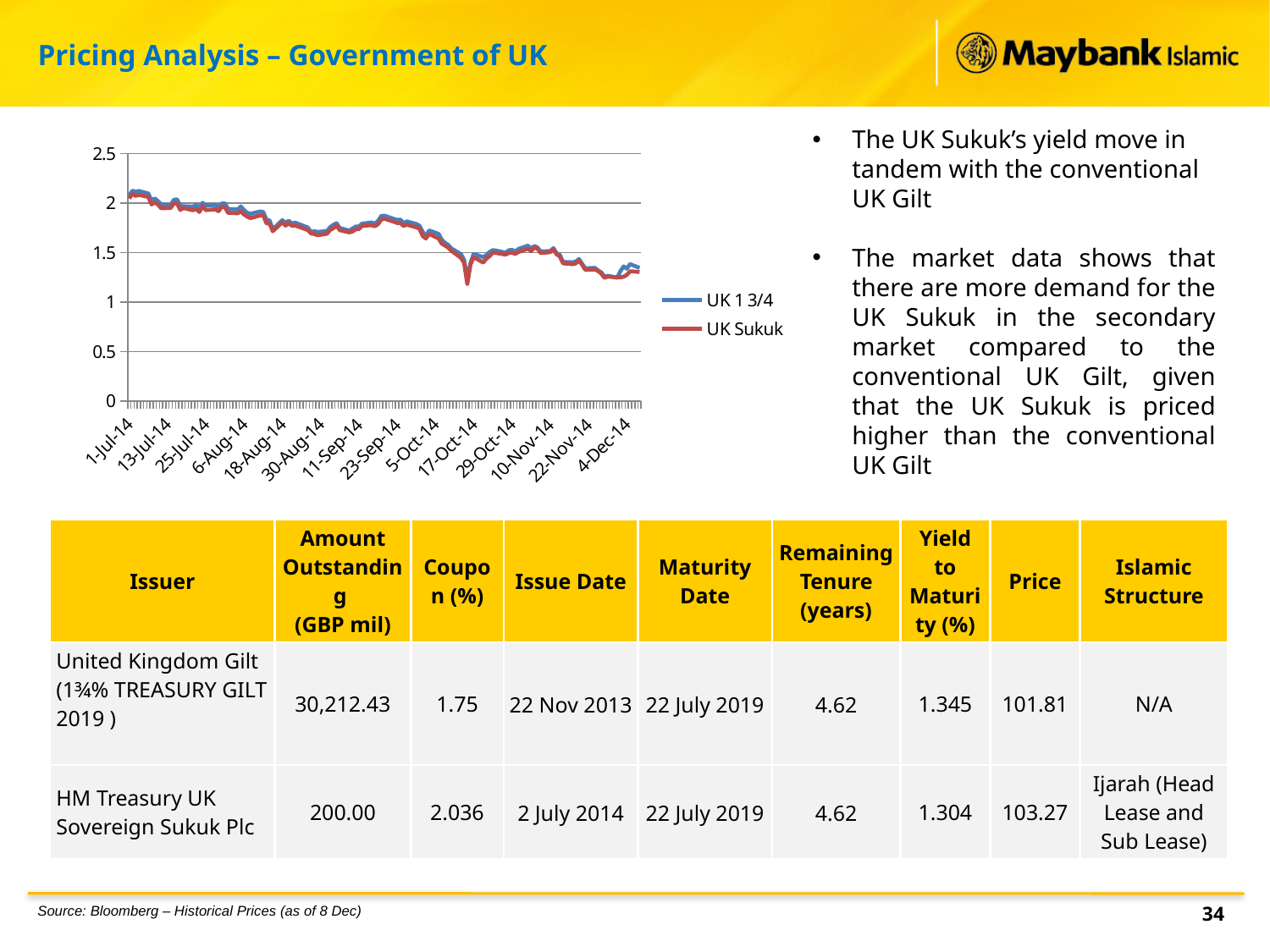
Is the value for UK 1 3/4 at 4-Dec-14 greater or less than 1.5? less Do the yields in the chart generally rise or fall from 1-Jul-14 to 4-Dec-14? fall Is the value for UK 1 3/4 at 11-Sep-14 greater or less than 2? less Is the value for UK Sukuk at 4-Dec-14 greater or less than 1? greater What is the first date label on the chart's horizontal axis? 1-Jul-14 What is the highest value shown on the chart's vertical axis? 2.5 What are the two series named in the chart's legend? UK 1 3/4 and UK Sukuk How many series does the chart's legend list? 2 Which colour is used for the UK Sukuk line in the chart? red What kind of chart is shown on the slide? line chart What is the last date label on the chart's horizontal axis? 4-Dec-14